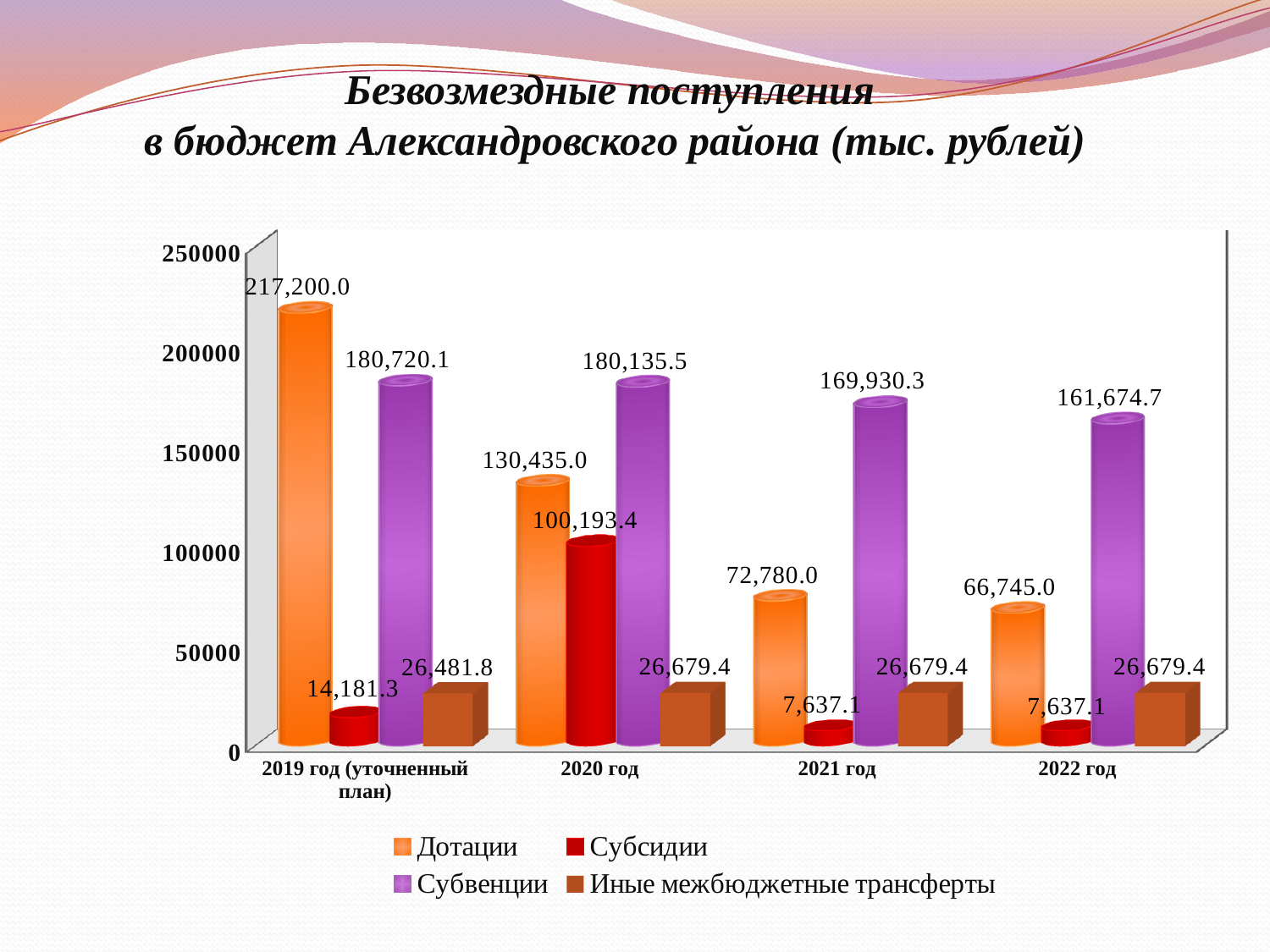
How many series does the legend list? 4 What is the value of Иные межбюджетные трансферты for 2019 год (уточненный план)? 26,481.8 How many year categories are shown on the x axis? 4 What is the value of Дотации for 2019 год (уточненный план)? 217,200.0 What is the value of Субвенции for 2022 год? 161,674.7 In which year is the Субвенции value the lowest? 2022 год Does the Субвенции value rise or fall from 2019 год (уточненный план) to 2022 год? fall Is the value of Субсидии for 2020 год greater or less than 50000? greater Which is larger in 2020 год: Дотации or Субвенции? Субвенции In which year is the Дотации value the highest? 2019 год (уточненный план) What is the difference between Дотации in 2019 год (уточненный план) and Дотации in 2020 год? 86,765.0 What is the value of Субсидии for 2020 год? 100,193.4